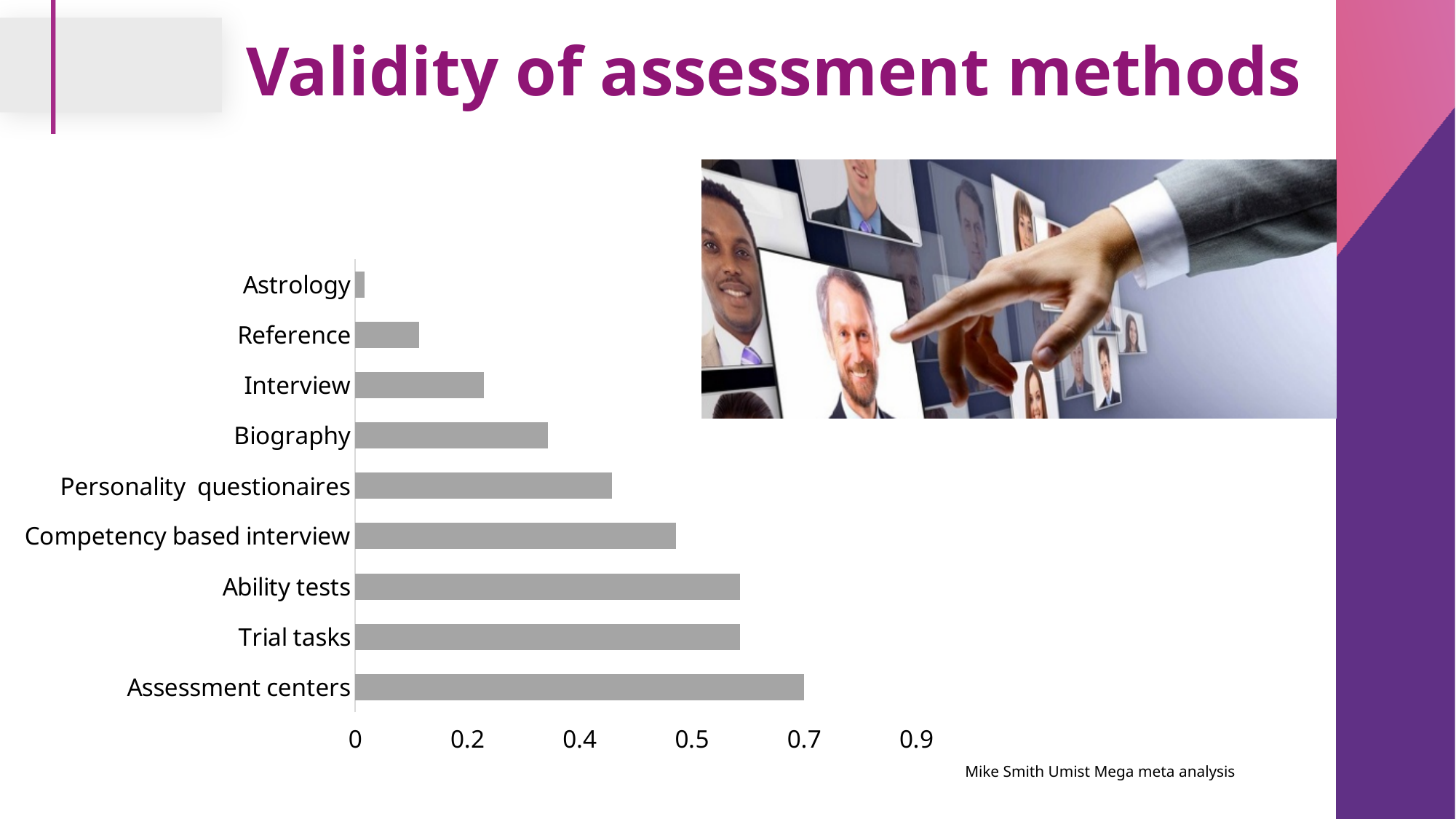
Which has a higher validity, Interview or Competency based interview? Competency based interview Is the value for Assessment centers greater or less than 0.5? greater What kind of chart is shown on the slide? bar chart How many assessment methods are listed on the chart? 9 Which has a higher validity, Biography or Reference? Biography Is the value for Astrology greater or less than 0.2? less Is the value for Ability tests greater or less than 0.5? greater Which assessment method has the lowest validity on the chart? Astrology Which assessment method has the highest validity on the chart? Assessment centers What is the title of the slide containing the chart? Validity of assessment methods